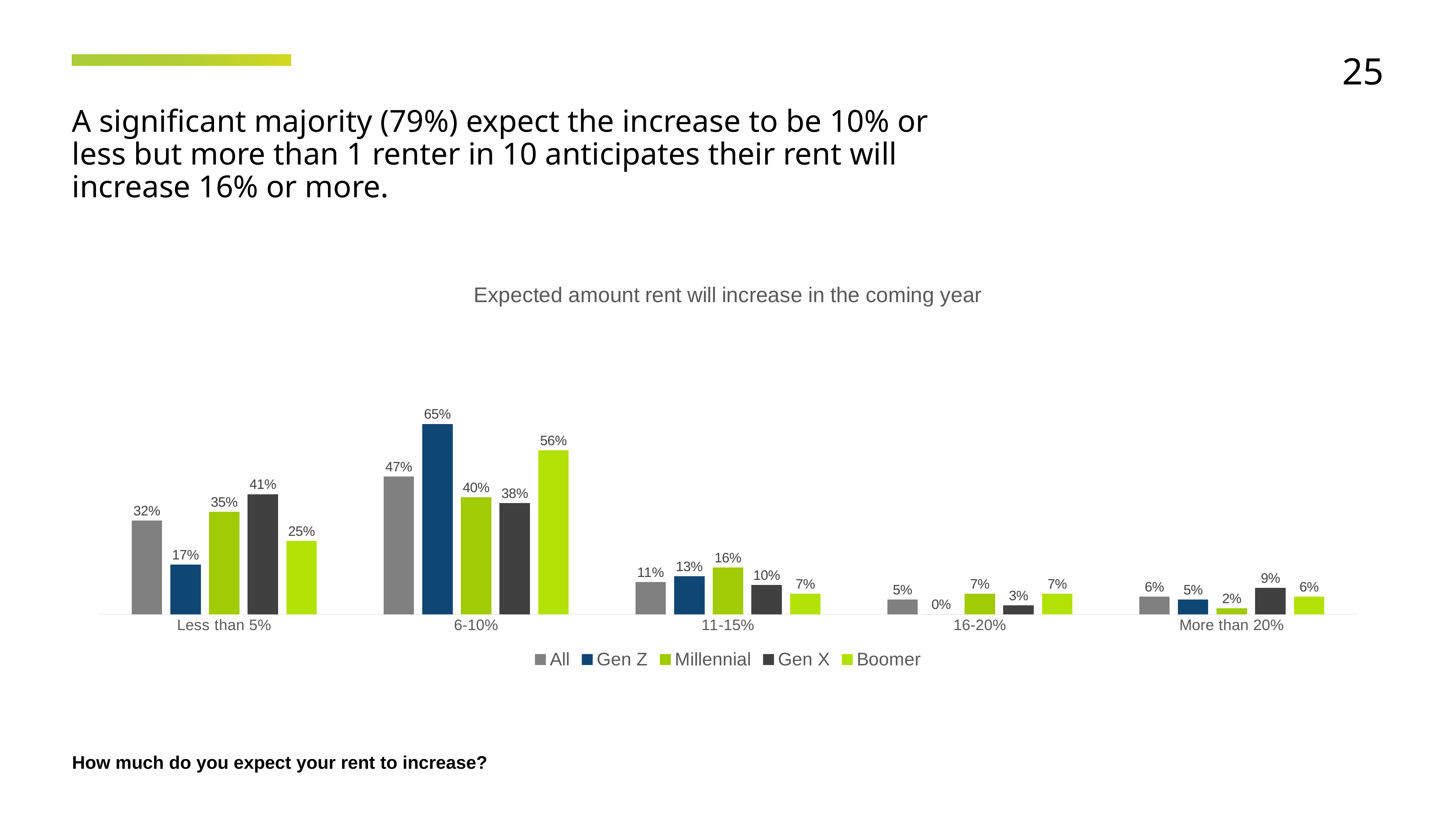
Which is larger in the Less than 5% category: the Gen X value or the Millennial value? Gen X What is the difference between the Gen Z and Millennial values in the 6-10% category? 25% How many series does the legend list? 5 Which category has the highest value for the All series? 6-10% What is the value for Gen Z in the 6-10% category? 65% What is the title of the chart? Expected amount rent will increase in the coming year What kind of chart is shown on the slide? Bar chart Which category has the lowest value for the Millennial series? More than 20% What is the value for Gen X in the More than 20% category? 9% What is the value for Gen Z in the 16-20% category? 0% How many categories are shown on the x axis? 5 What is the value for Boomer in the Less than 5% category? 25%